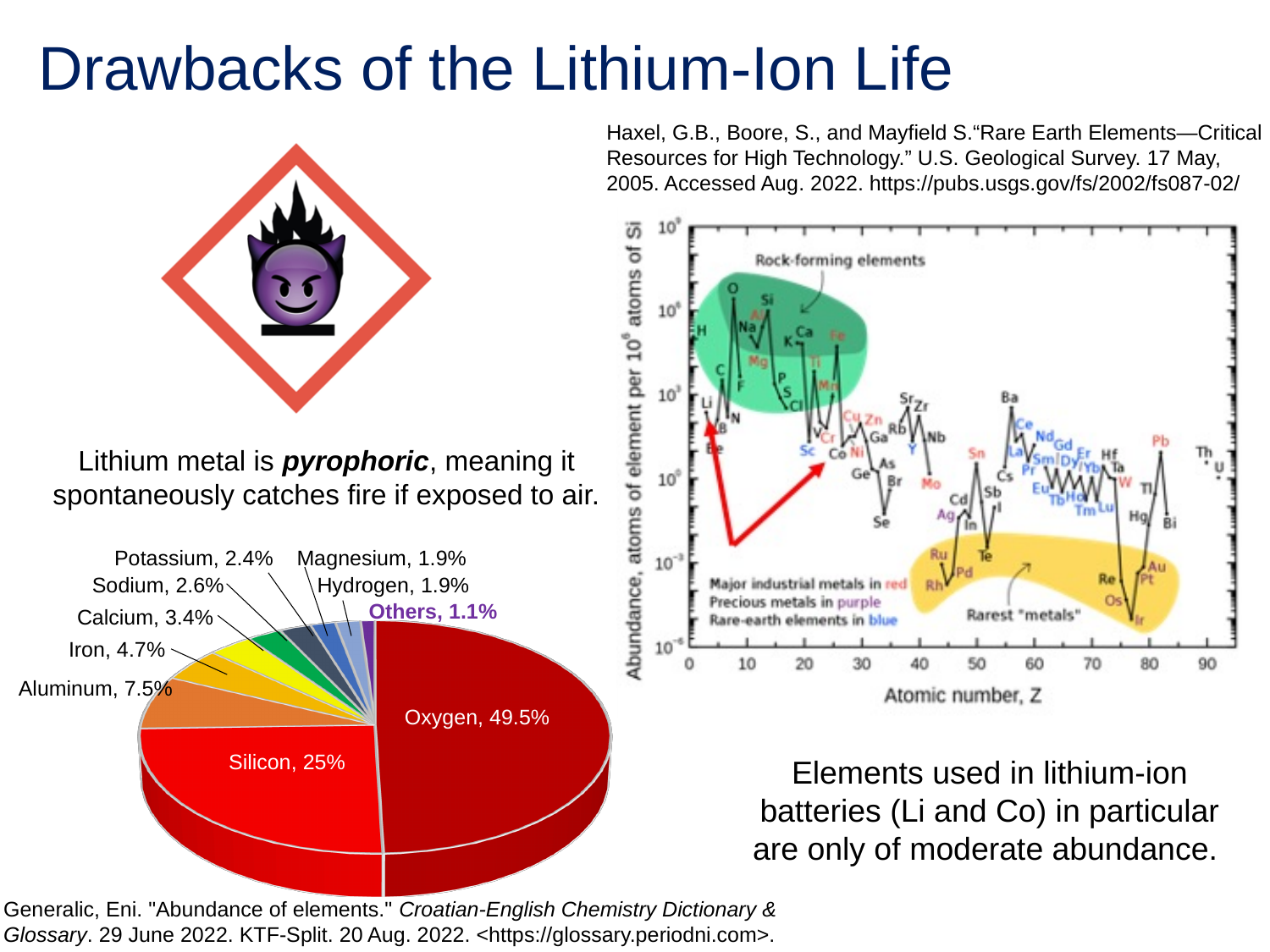
In the pie chart, what percentage is shown for Calcium? 3.4% In the pie chart, what is the difference between the Oxygen and Silicon percentages? 24.5% What kind of chart is the chart in the lower left of the slide? Pie chart In the pie chart, what percentage is shown for Silicon? 25% In the pie chart, which slice is the largest? Oxygen In the pie chart, what do Oxygen and Silicon add up to? 74.5% How many slices does the pie chart have? 10 In the pie chart, what percentage is shown for Oxygen? 49.5% In the chart on the right, what is the label of the x axis? Atomic number, Z In the chart on the right, is the abundance of Ba greater or less than 10^0? greater In the pie chart, which slice is the smallest? Others In the pie chart, which is larger, Aluminum or Iron? Aluminum